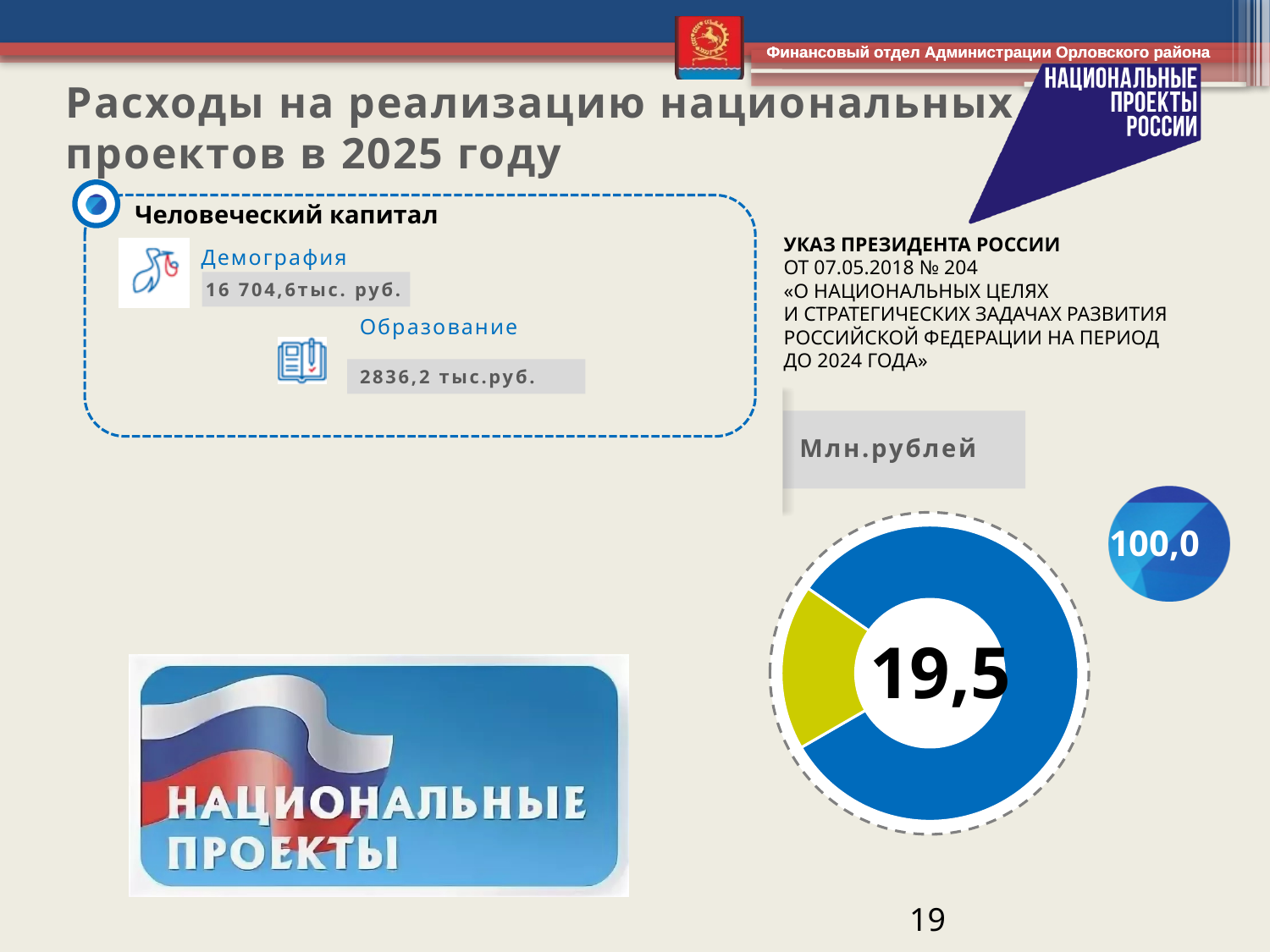
Which slice of the doughnut chart is larger, the blue one or the yellow one? blue What value is printed in the centre of the doughnut chart? 19,5 How many slices does the doughnut chart have? 2 What colour is the smaller slice of the doughnut chart? yellow What unit label is shown above the doughnut chart? Млн.рублей Does the blue slice of the doughnut chart cover more or less than half of the ring? more What number is printed in the blue circle badge next to the doughnut chart? 100,0 What kind of chart is shown on the right side of the slide? doughnut chart